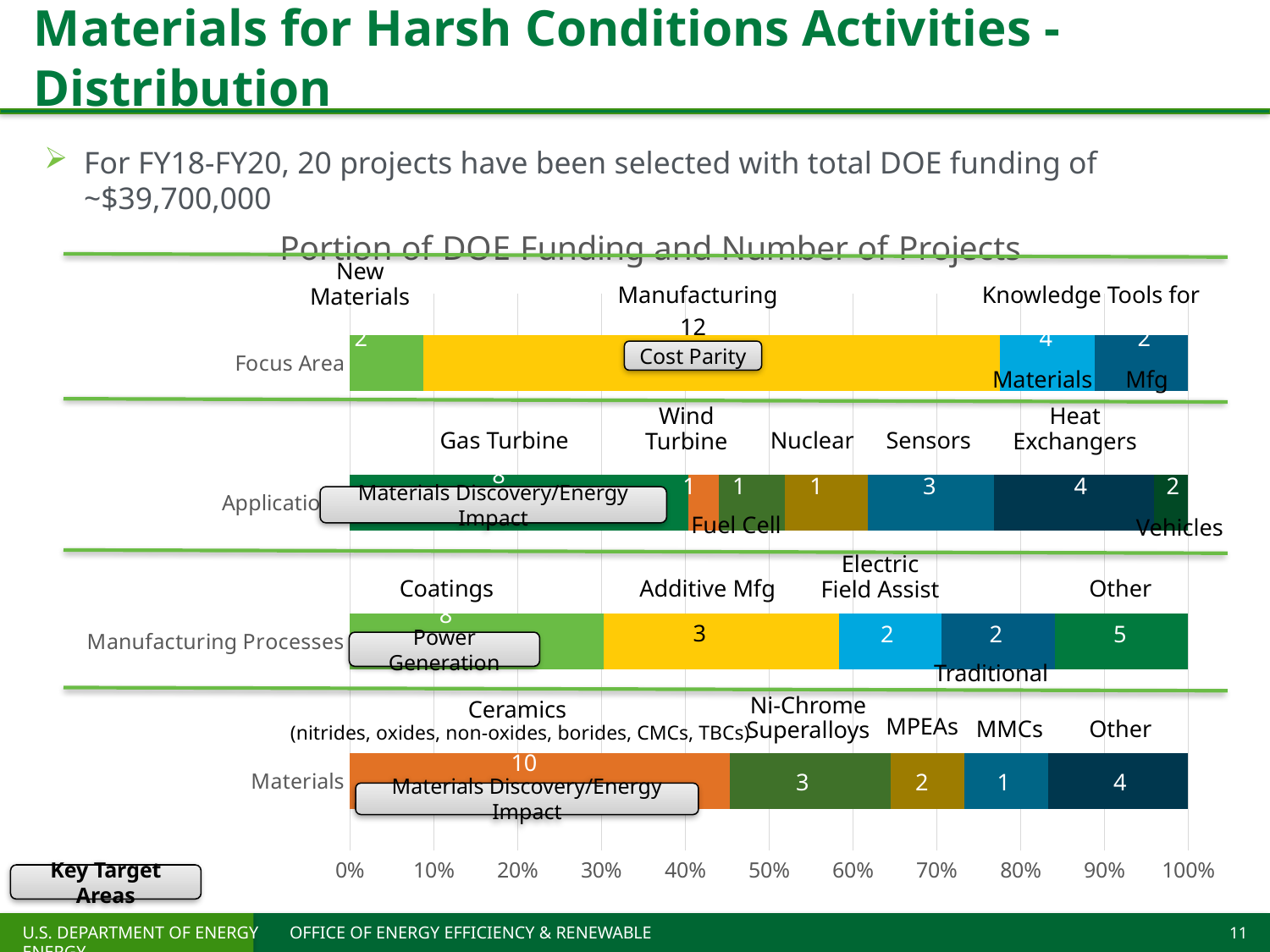
In the Materials bar, how many projects are labelled for MPEAs? 2 In the Materials bar, how many projects are labelled for Ceramics? 10 What is the total number of projects across all segments of the Focus Area bar? 20 What kind of chart is shown on the slide? Stacked bar chart In the Focus Area bar, how many projects are labelled for Manufacturing? 12 What is the title of the chart? Portion of DOE Funding and Number of Projects In the Materials bar, what is the difference between the number of Ceramics projects and Ni-Chrome Superalloys projects? 7 Which segment of the Materials bar has the lowest number of projects? MMCs In the Application bar, which has more projects: Sensors or Heat Exchangers? Heat Exchangers In the Application bar, how many projects are labelled for Heat Exchangers? 4 Which segment of the Materials bar has the highest number of projects? Ceramics In the Manufacturing Processes bar, how many projects are labelled for Other? 5